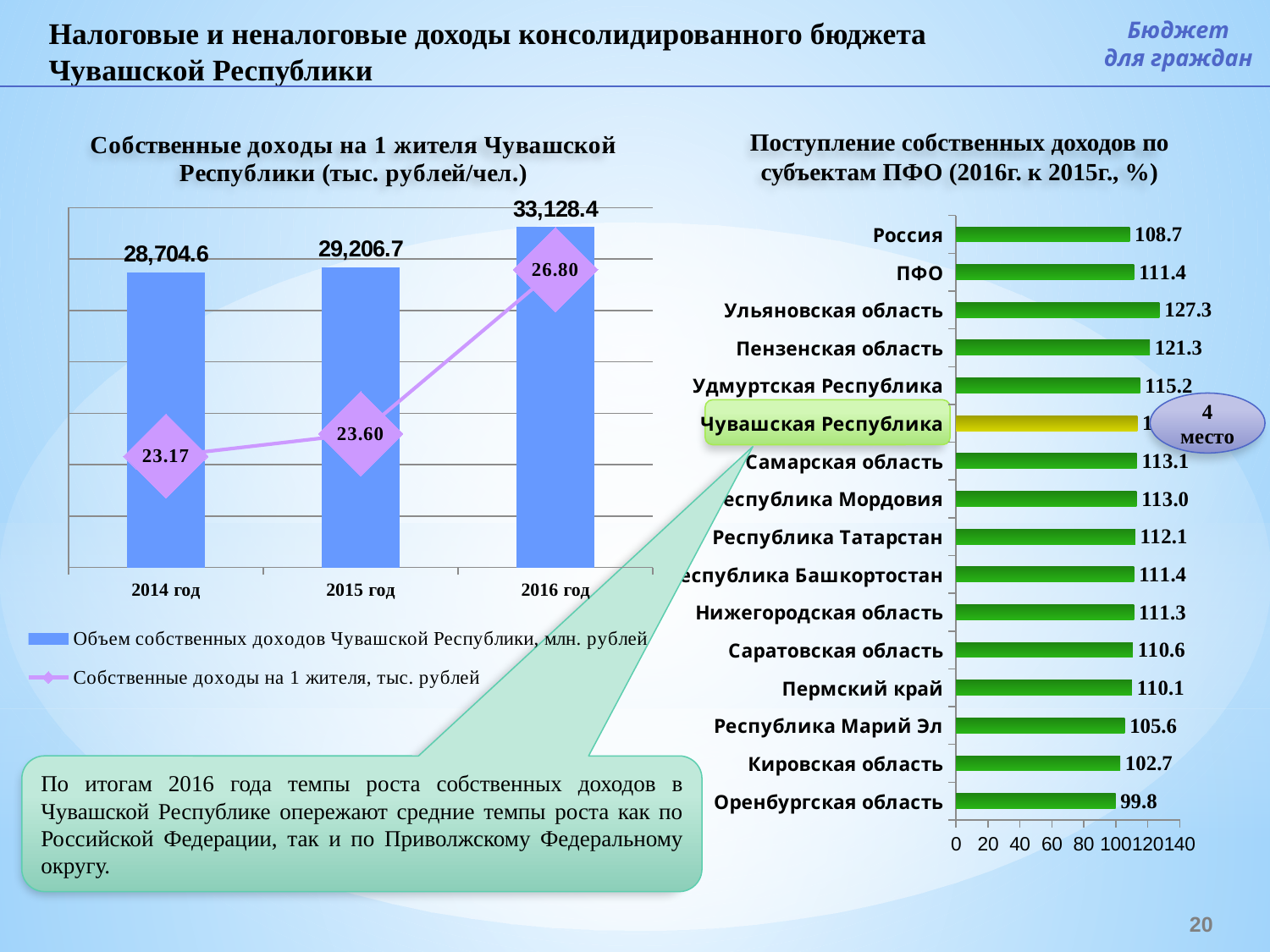
In the right chart 'Поступление собственных доходов по субъектам ПФО', which region has the lowest value? Оренбургская область In the right chart 'Поступление собственных доходов по субъектам ПФО', which is larger: the value for Россия or the value for ПФО? ПФО In the left chart 'Собственные доходы на 1 жителя Чувашской Республики', by how much did the bar value increase from 2015 год to 2016 год? 3,921.7 In the right chart 'Поступление собственных доходов по субъектам ПФО', what is the difference between the values for Удмуртская Республика and Самарская область? 2.1 In the right chart 'Поступление собственных доходов по субъектам ПФО', which region has the highest value? Ульяновская область In the right chart 'Поступление собственных доходов по субъектам ПФО', what is the value for Пензенская область? 121.3 In the left chart 'Собственные доходы на 1 жителя Чувашской Республики', do the line values rise or fall from 2014 год to 2016 год? rise How many series does the legend of the left chart 'Собственные доходы на 1 жителя Чувашской Республики' list? 2 In the left chart 'Собственные доходы на 1 жителя Чувашской Республики', what is the value of the line marker for 2014 год? 23.17 What type of chart is the right chart 'Поступление собственных доходов по субъектам ПФО'? bar chart In the left chart 'Собственные доходы на 1 жителя Чувашской Республики', which year has the lowest bar value? 2014 год In the left chart 'Собственные доходы на 1 жителя Чувашской Республики', what is the value of the bar for 2016 год? 33,128.4